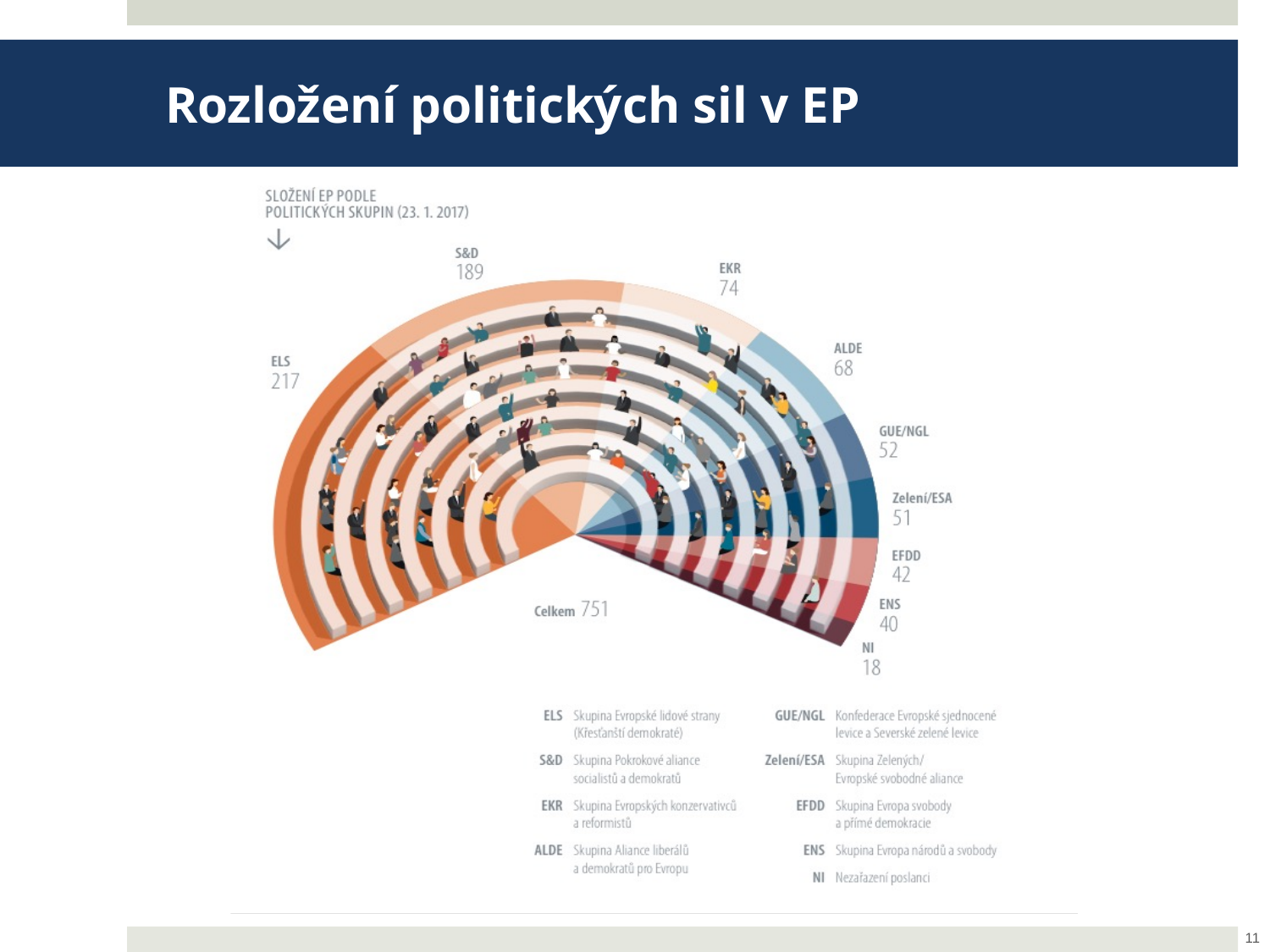
What is the total number of seats (Celkem) shown in the chart? 751 What kind of chart is used to show the composition of the EP? A semicircular parliament (hemicycle) chart Which group has more seats, EKR or ALDE? EKR What is the difference in seats between ELS and S&D? 28 What is the value shown for EFDD? 42 Which political group has the largest number of seats in the chart? ELS How many political groups are shown in the chart? 9 What date is given in the chart's subtitle for the composition of the EP? 23. 1. 2017 How many seats does the ELS group have in the chart? 217 How many seats are shown for GUE/NGL? 52 What is the number of seats shown for S&D? 189 Which group has the smallest number of seats in the chart? NI